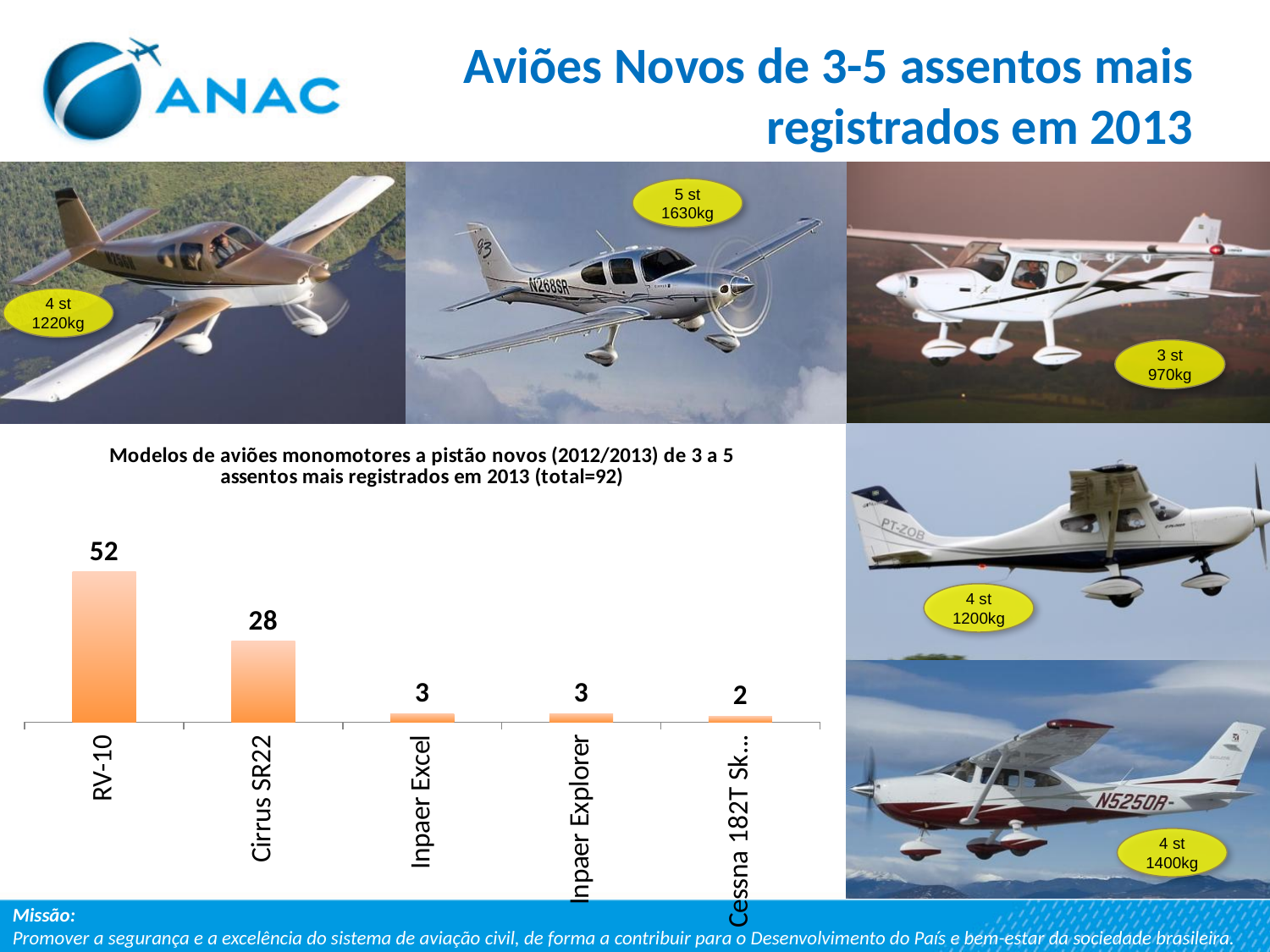
Do the values rise or fall from left to right across the chart? Fall How many aircraft models are shown as bars in the chart? 5 What is the difference between the values for RV-10 and Cirrus SR22? 24 What kind of chart is used to show the registered aircraft models? Bar chart Which is larger, the value for Cirrus SR22 or the value for Inpaer Explorer? Cirrus SR22 What value is shown for Cirrus SR22? 28 What value is shown for the last bar, labelled Cessna 182T Sk…? 2 According to the chart title, what is the total number of registrations? 92 What value is shown for Inpaer Excel? 3 Which model has the lowest value in the chart? Cessna 182T Sk… What value is shown for RV-10? 52 Which model has the highest number of registrations in the chart? RV-10